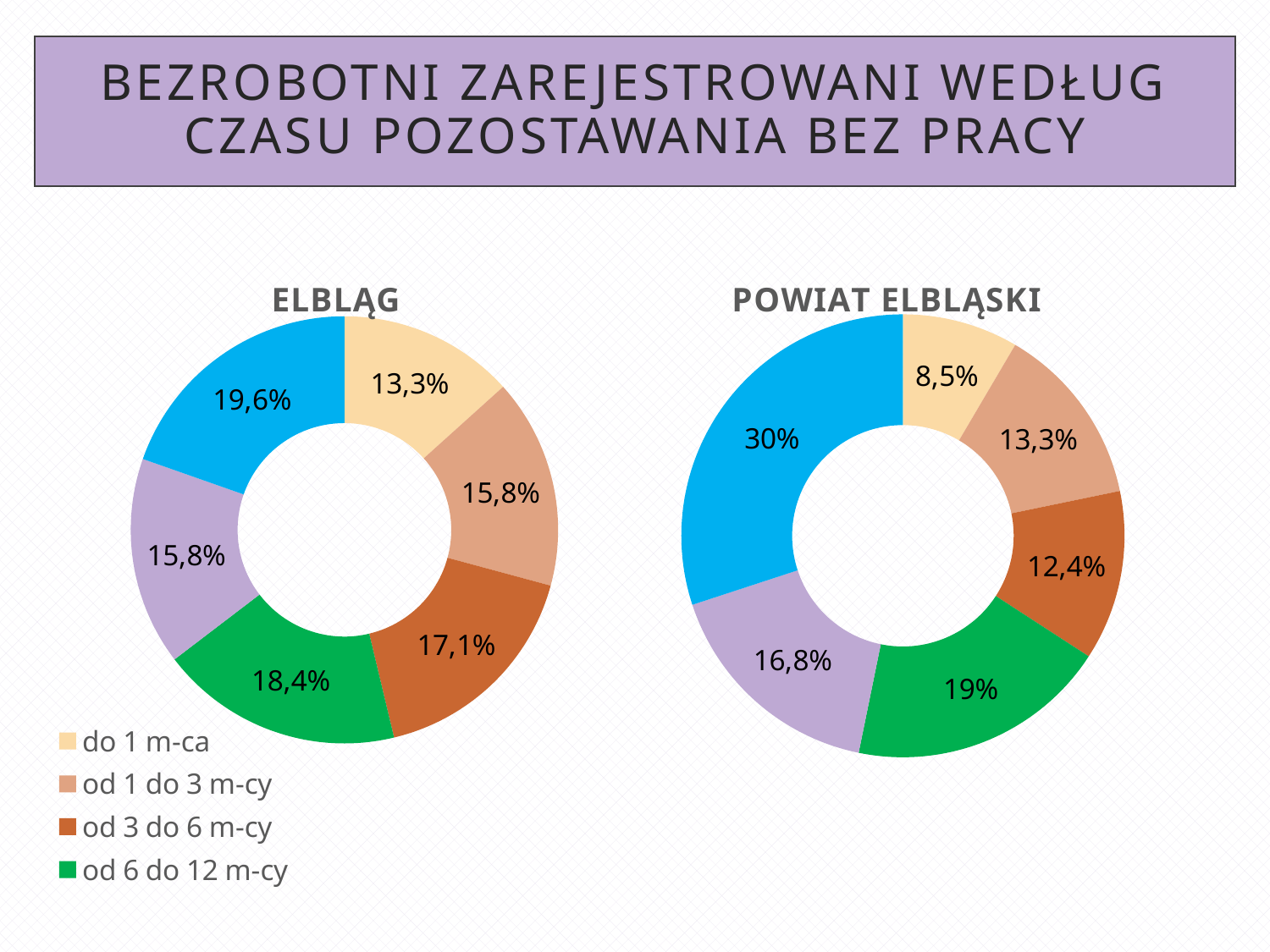
In the POWIAT ELBLĄSKI chart, how many percentage points larger is 'od 6 do 12 m-cy' than 'do 1 m-ca'? 10,5 In the POWIAT ELBLĄSKI chart, what share is shown for 'od 6 do 12 m-cy'? 19% In the ELBLĄG chart, which is larger: 'od 3 do 6 m-cy' or 'od 1 do 3 m-cy'? od 3 do 6 m-cy In the POWIAT ELBLĄSKI chart, what share is shown for 'od 3 do 6 m-cy'? 12,4% How many slices does the ELBLĄG chart have? 6 What is the title of the chart on the left? ELBLĄG In the ELBLĄG chart, what is the largest percentage shown on any slice? 19,6% In the ELBLĄG chart, what share is shown for 'do 1 m-ca'? 13,3% In the ELBLĄG chart, what share is shown for 'od 3 do 6 m-cy'? 17,1% In the POWIAT ELBLĄSKI chart, which legend category has the smallest share? do 1 m-ca What type of chart is used for POWIAT ELBLĄSKI? Doughnut (pie) chart In the POWIAT ELBLĄSKI chart, what is the largest percentage shown on any slice? 30%